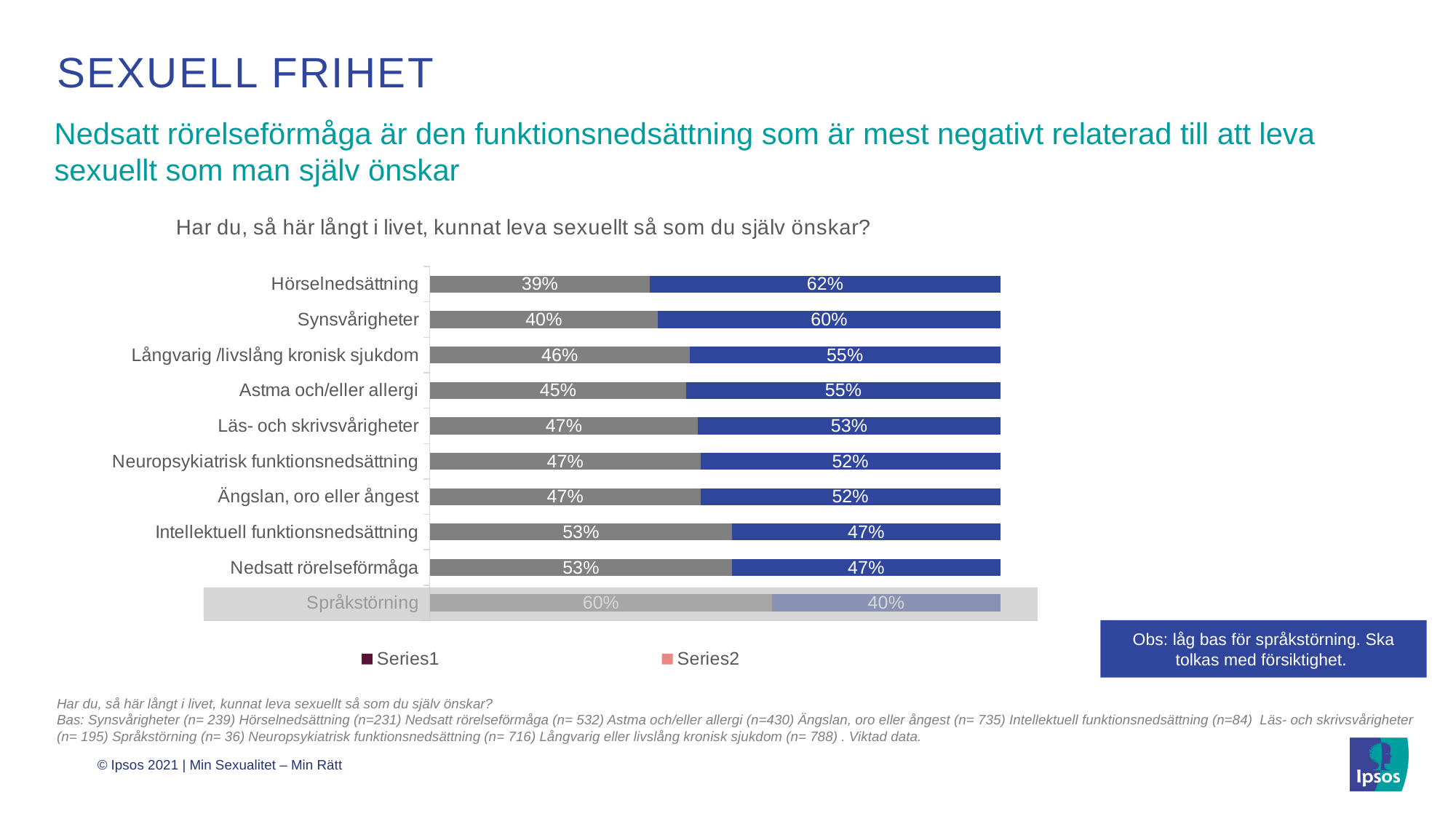
What is the Series1 (grey segment) value for Språkstörning? 60% What is the Series1 (grey segment) value for Nedsatt rörelseförmåga? 53% How many series does the legend list? 2 What is the Series2 (blue segment) value for Hörselnedsättning? 62% What is the total of the stacked bar for Synsvårigheter? 100% Which is larger: the Series1 value for Synsvårigheter or the Series1 value for Intellektuell funktionsnedsättning? Intellektuell funktionsnedsättning What is the difference between the Series2 values for Hörselnedsättning and Språkstörning? 22% What is the Series2 (blue segment) value for Läs- och skrivsvårigheter? 53% Which category has the lowest Series1 (grey segment) value? Hörselnedsättning Which category has the highest Series2 (blue segment) value? Hörselnedsättning What kind of chart is shown on the slide? Stacked bar chart How many categories are shown in the chart? 10